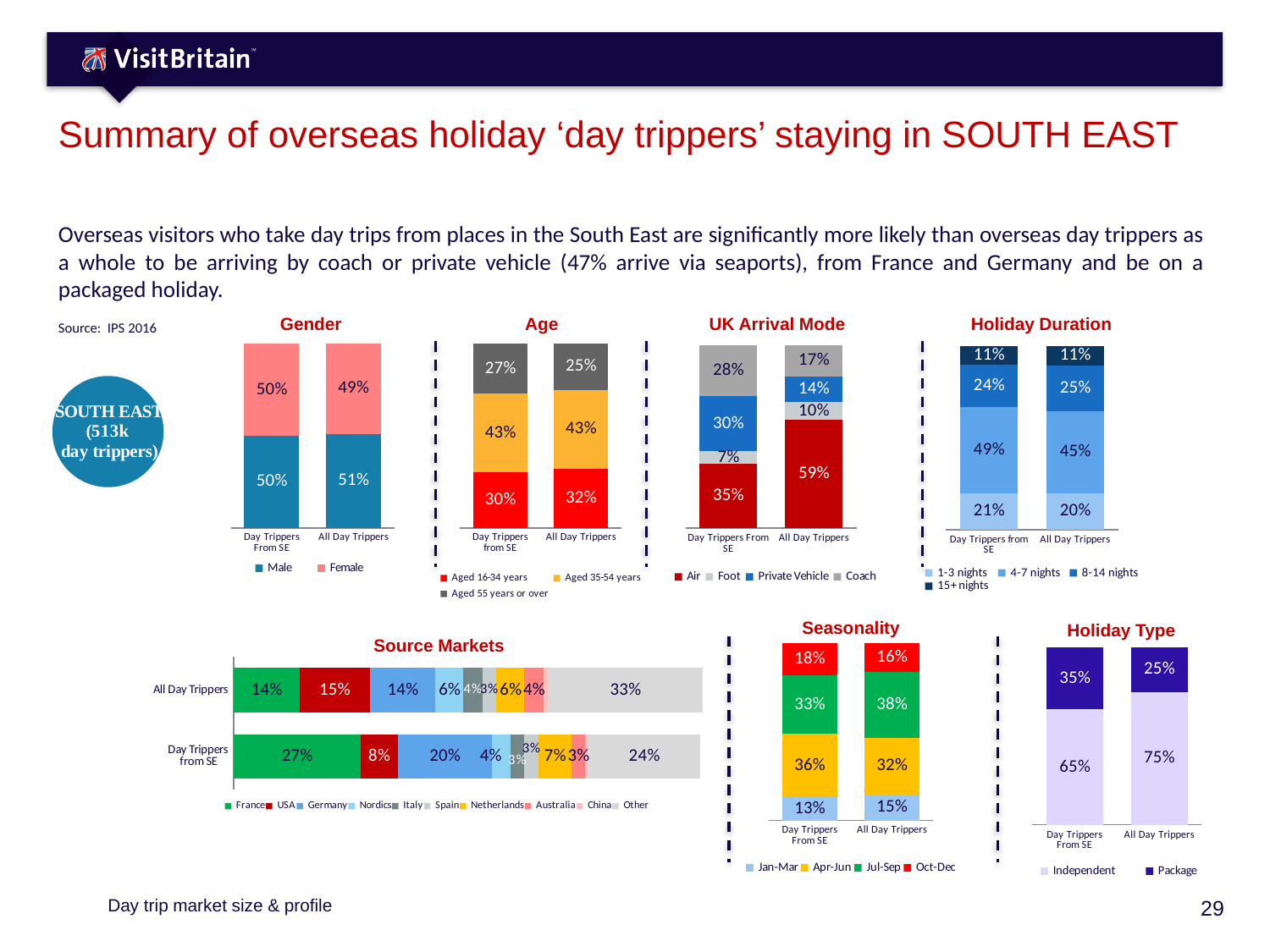
In the Seasonality chart, which quarter has the smallest share for Day Trippers From SE? Jan-Mar What kind of chart is the Source Markets chart? Stacked bar chart In the UK Arrival Mode chart, what percentage of All Day Trippers arrive by Coach? 17% In the UK Arrival Mode chart, what percentage of Day Trippers From SE arrive by Air? 35% In the Seasonality chart, which is larger for All Day Trippers: Apr-Jun or Jul-Sep? Jul-Sep In the Source Markets chart, which source market has the largest share for Day Trippers from SE, excluding Other? France In the Holiday Type chart, what is the difference between the Package share for Day Trippers From SE and for All Day Trippers? 10% In the Source Markets chart, what is the share of Germany for Day Trippers from SE? 20% In the Age chart, what percentage of All Day Trippers are aged 55 years or over? 25% How many series does the legend of the UK Arrival Mode chart list? 4 In the Holiday Duration chart, what share of Day Trippers from SE stay 4-7 nights? 49% In the Gender chart, what percentage of All Day Trippers are Female? 49%